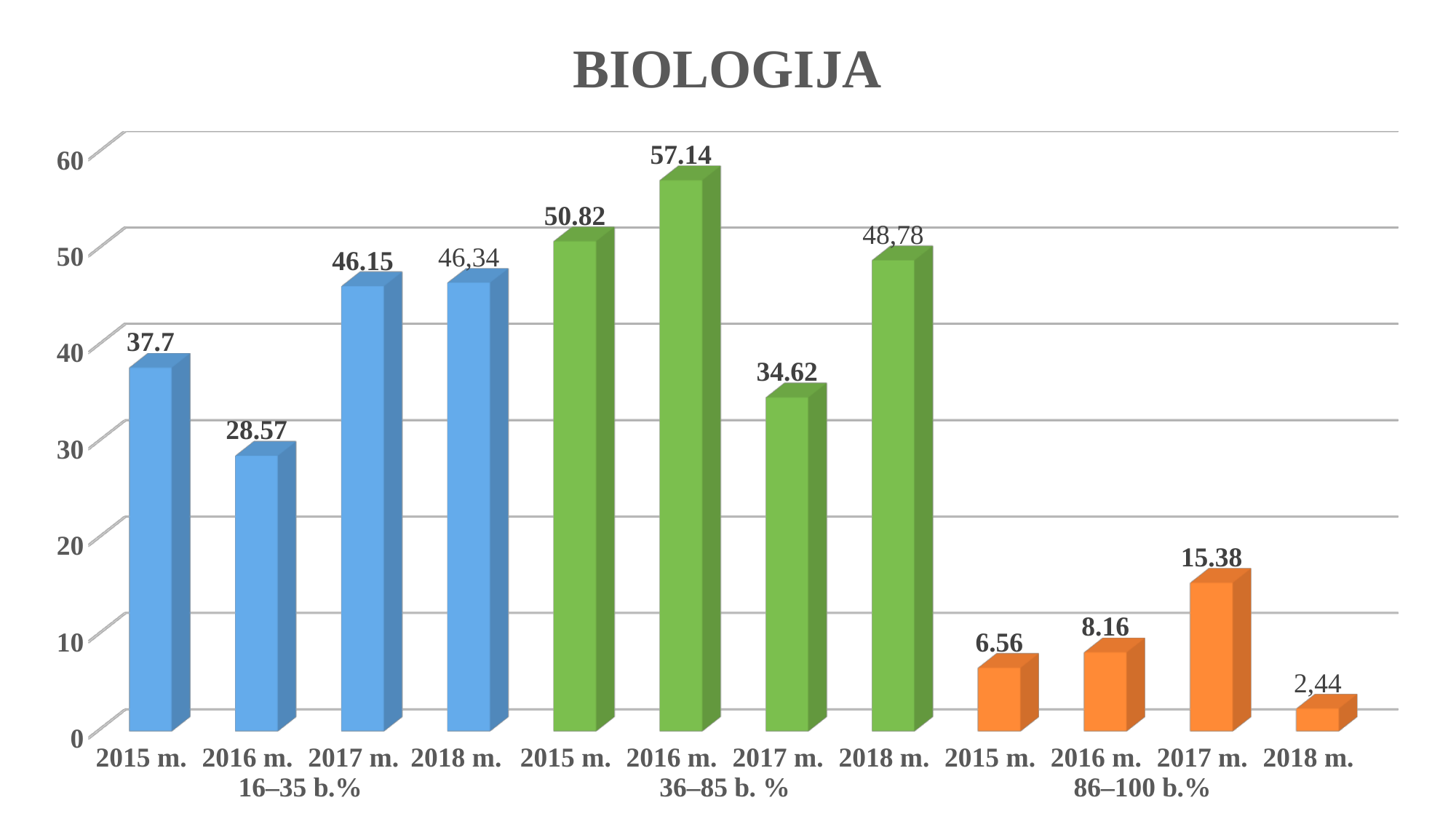
What is the value for 2017 m. in the 86–100 b.% group? 15.38 What kind of chart is shown on the slide? bar chart Which bar has the lowest value on the chart? 2018 m. in the 86–100 b.% group (2,44) What is the value for 2016 m. in the 16–35 b.% group? 28.57 In the 86–100 b.% group, do the values rise or fall from 2015 m. to 2017 m.? rise Is the value for 2017 m. in the 36–85 b. % group greater or less than 40? less How many bars are plotted on the chart? 12 What is the title of the chart? BIOLOGIJA What is the value for 2018 m. in the 36–85 b. % group? 48,78 Which bar has the highest value on the chart? 2016 m. in the 36–85 b. % group (57.14) What is the difference between the 2015 m. and 2016 m. values in the 86–100 b.% group? 1.6 Which is larger: the 2015 m. value in the 16–35 b.% group or the 2015 m. value in the 36–85 b. % group? 2015 m. in the 36–85 b. % group